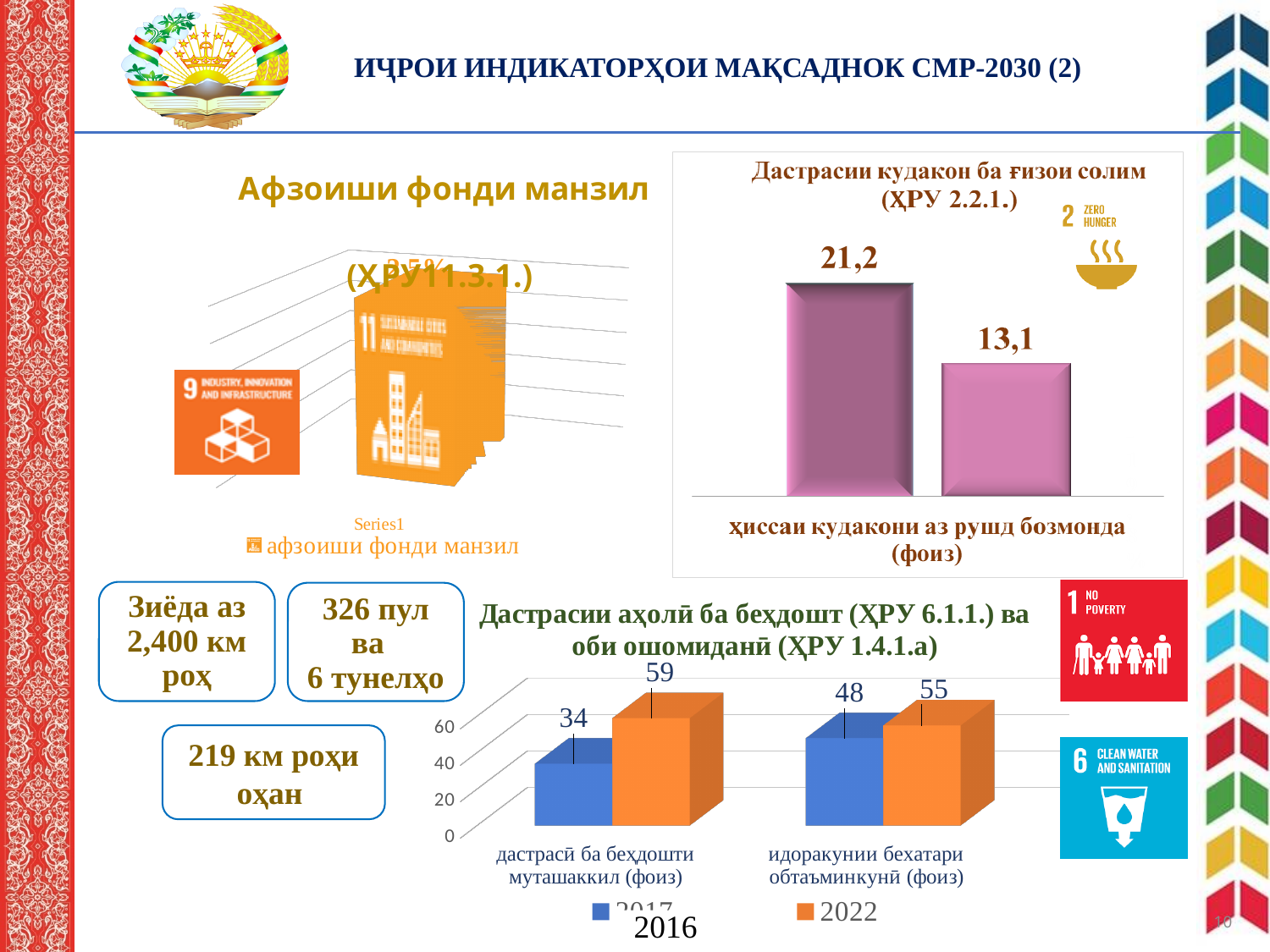
In the bottom chart 'Дастрасии аҳолӣ ба беҳдошт (ҲРУ 6.1.1.) ва оби ошомиданӣ (ҲРУ 1.4.1.а)', what is the value of the blue series for 'дастрасӣ ба беҳдошти муташаккил (фоиз)'? 34 How many categories are shown on the x axis of the bottom chart 'Дастрасии аҳолӣ ба беҳдошт (ҲРУ 6.1.1.) ва оби ошомиданӣ (ҲРУ 1.4.1.а)'? 2 In the chart titled 'Дастрасии кудакон ба ғизои солим (ҲРУ 2.2.1.)', what is the highest value shown? 21,2 In the chart titled 'Дастрасии кудакон ба ғизои солим (ҲРУ 2.2.1.)', what is the lowest value shown? 13,1 In the bottom chart 'Дастрасии аҳолӣ ба беҳдошт (ҲРУ 6.1.1.) ва оби ошомиданӣ (ҲРУ 1.4.1.а)', what is the 2022 value for 'идоракунии бехатари обтаъминкунӣ (фоиз)'? 55 How many bars are plotted in the chart titled 'Дастрасии кудакон ба ғизои солим (ҲРУ 2.2.1.)'? 2 In the bottom chart 'Дастрасии аҳолӣ ба беҳдошт (ҲРУ 6.1.1.) ва оби ошомиданӣ (ҲРУ 1.4.1.а)', what is the difference between the 2022 value and the blue series value for 'дастрасӣ ба беҳдошти муташаккил (фоиз)'? 25 In the chart titled 'Дастрасии кудакон ба ғизои солим (ҲРУ 2.2.1.)', what is the difference between the two bar values? 8,1 What kind of chart is the one titled 'Дастрасии кудакон ба ғизои солим (ҲРУ 2.2.1.)'? bar chart In the bottom chart 'Дастрасии аҳолӣ ба беҳдошт (ҲРУ 6.1.1.) ва оби ошомиданӣ (ҲРУ 1.4.1.а)', what is the 2022 value for 'дастрасӣ ба беҳдошти муташаккил (фоиз)'? 59 In the bottom chart 'Дастрасии аҳолӣ ба беҳдошт (ҲРУ 6.1.1.) ва оби ошомиданӣ (ҲРУ 1.4.1.а)', what is the difference between the 2022 value and the blue series value for 'идоракунии бехатари обтаъминкунӣ (фоиз)'? 7 In the bottom chart 'Дастрасии аҳолӣ ба беҳдошт (ҲРУ 6.1.1.) ва оби ошомиданӣ (ҲРУ 1.4.1.а)', which category has the larger 2022 value? дастрасӣ ба беҳдошти муташаккил (фоиз)